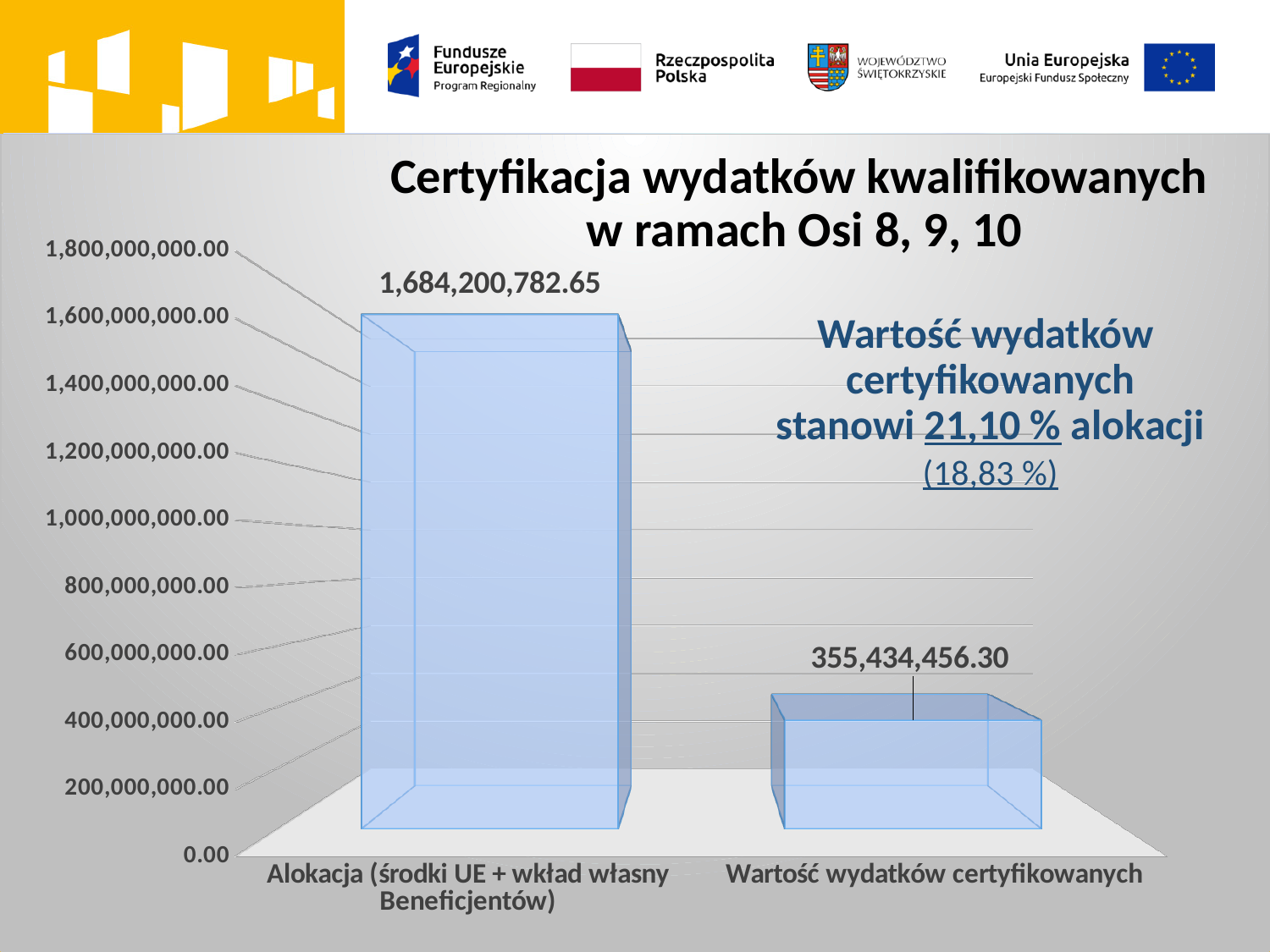
Which category has the highest value? Alokacja (środki UE + wkład własny Beneficjentów) Which category has the lowest value? Wartość wydatków certyfikowanych What is the title of the chart? Certyfikacja wydatków kwalifikowanych w ramach Osi 8, 9, 10 What is the value of the bar for Wartość wydatków certyfikowanych? 355,434,456.30 What is the difference between the Alokacja bar and the Wartość wydatków certyfikowanych bar? 1,328,766,326.35 What kind of chart is shown on the slide? Bar chart Is the value for Wartość wydatków certyfikowanych greater or less than 400,000,000.00? less What is the highest value shown on the vertical axis? 1,800,000,000.00 Is the value for Alokacja (środki UE + wkład własny Beneficjentów) greater or less than 1,600,000,000.00? greater How many categories are shown on the chart? 2 What is the value of the bar for Alokacja (środki UE + wkład własny Beneficjentów)? 1,684,200,782.65 Which is larger: Alokacja (środki UE + wkład własny Beneficjentów) or Wartość wydatków certyfikowanych? Alokacja (środki UE + wkład własny Beneficjentów)